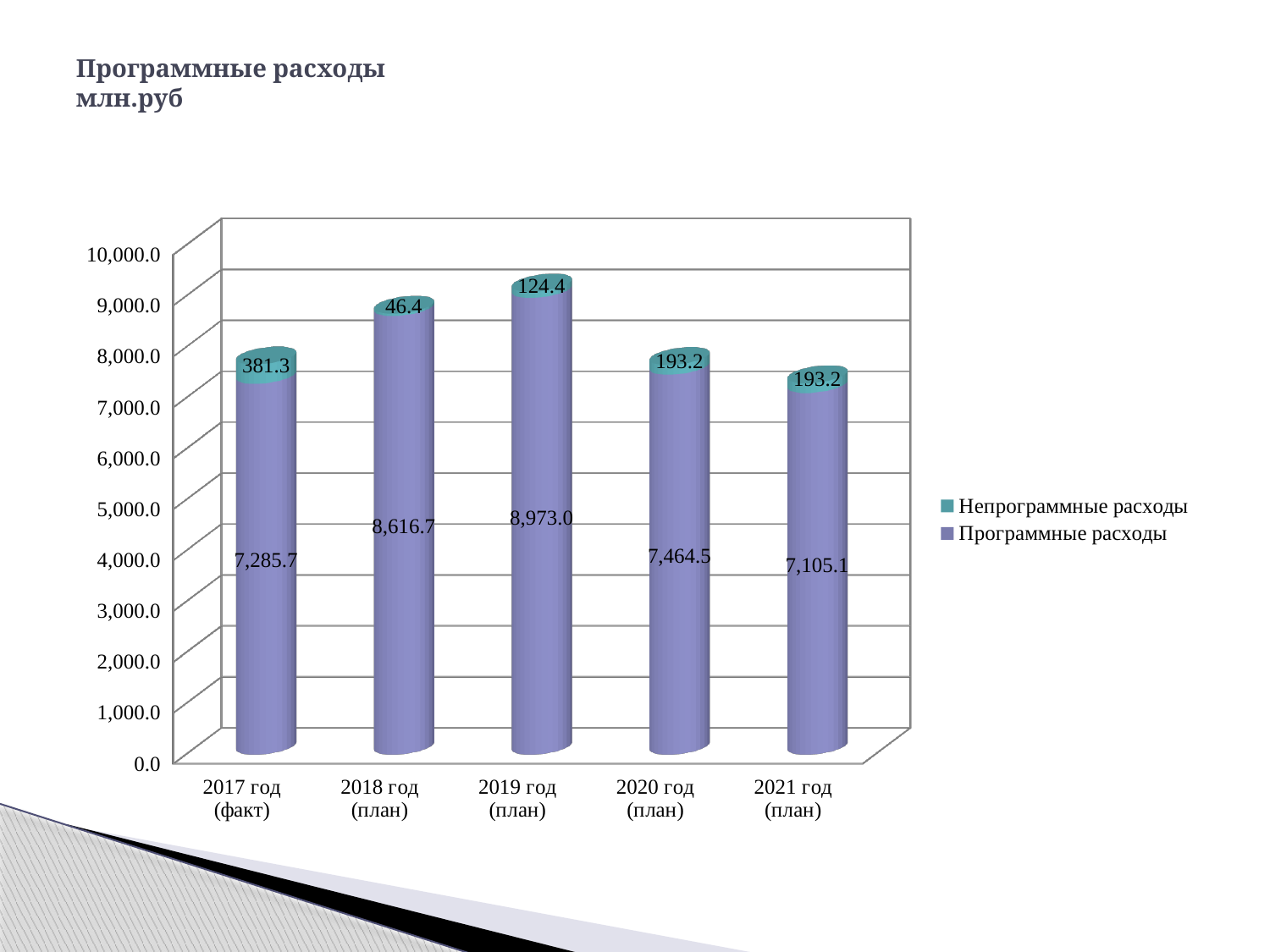
What is the value of Программные расходы for 2021 год (план)? 7,105.1 How many years are shown on the x axis? 5 Which year has the highest value of Программные расходы? 2019 год (план) What is the total of the stacked bar for 2019 год (план)? 9,097.4 What is the value of Непрограммные расходы for 2017 год (факт)? 381.3 What is the value of Программные расходы for 2019 год (план)? 8,973.0 What is the difference between Программные расходы in 2018 год (план) and 2017 год (факт)? 1,331.0 Which year has the lowest value of Непрограммные расходы? 2018 год (план) What is the total of the stacked bar for 2017 год (факт)? 7,667.0 How many series does the legend list? 2 Which is larger, Программные расходы in 2020 год (план) or in 2021 год (план)? 2020 год (план) What kind of chart is shown on the slide? Stacked bar chart